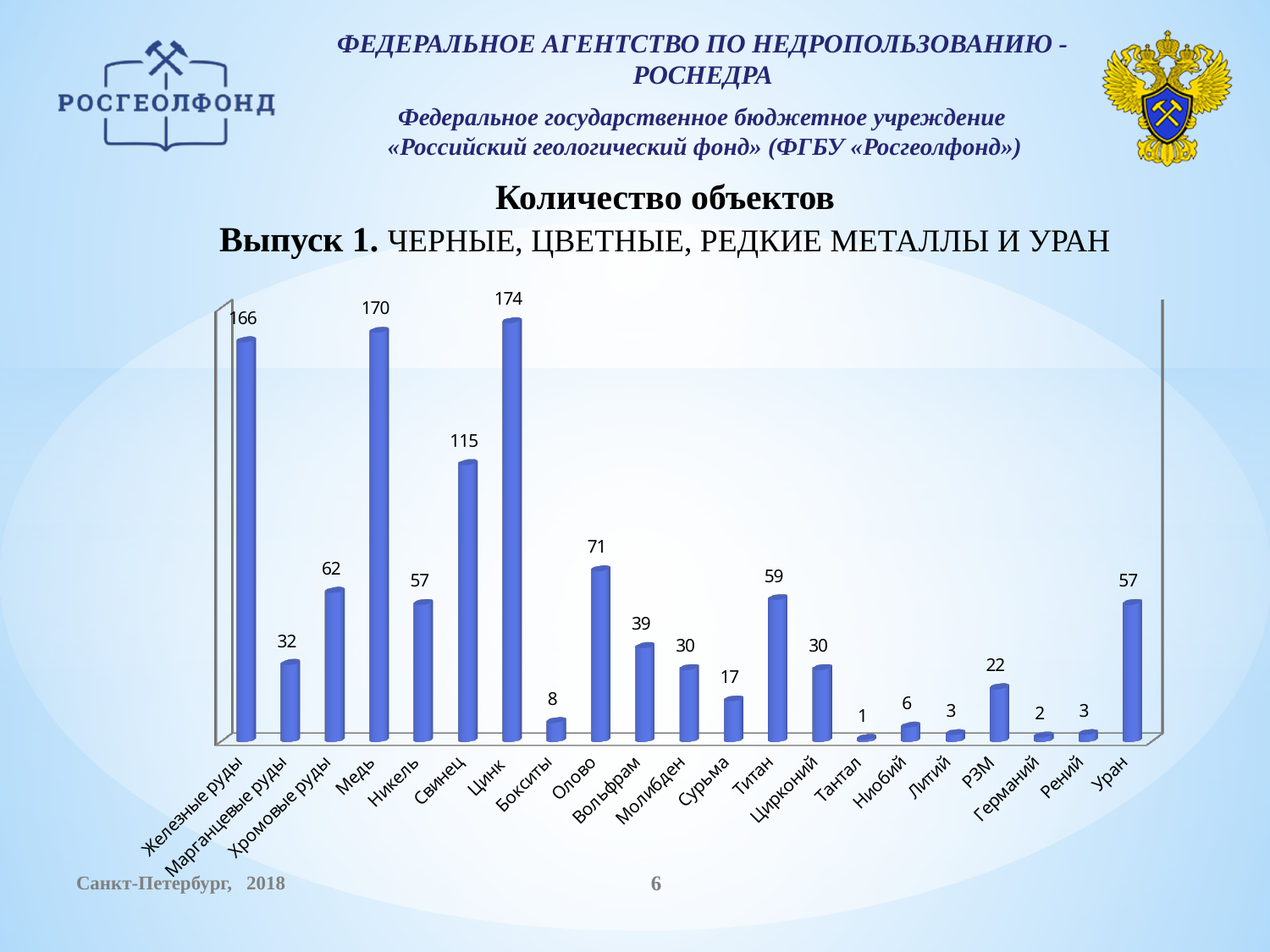
What is the difference between the values for Олово and Вольфрам? 32 What is the value for Уран? 57 How many categories are shown on the chart? 21 What is the value for Медь? 170 Which category has the lowest value? Тантал What is the title of the chart? Количество объектов. Выпуск 1. ЧЕРНЫЕ, ЦВЕТНЫЕ, РЕДКИЕ МЕТАЛЛЫ И УРАН What kind of chart is shown on the slide? bar chart What is the value for Свинец? 115 What is the difference between the values for Цинк and Железные руды? 8 Which category has the highest value? Цинк What is the value for РЗМ? 22 Which is larger, the value for Титан or the value for Хромовые руды? Хромовые руды